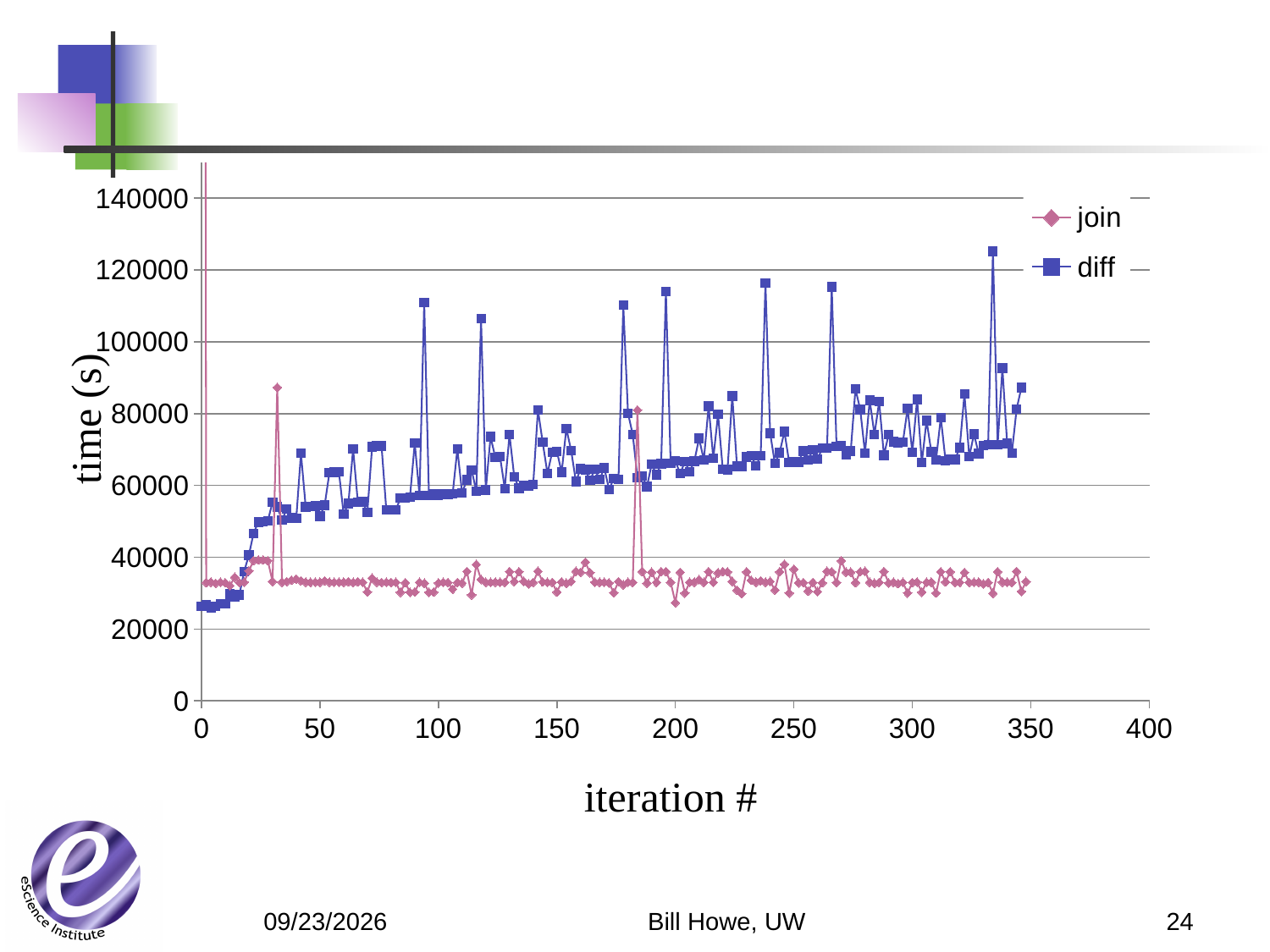
How many series does the legend list? 2 What kind of chart is shown on the slide? line chart What are the two series named in the legend? join and diff Is the value of the diff series at iteration 300 greater or less than 60000? greater Is the value of the diff series at iteration 0 greater or less than 40000? less Which series has the higher values at iteration 100, join or diff? diff Is the value of the join series at iteration 100 greater or less than 20000? greater Which series reaches the highest plotted value on the chart? join Does the diff series generally rise or fall as the iteration number increases? rise Which series has the lowest plotted value on the chart? diff What is the label of the y axis? time (s)